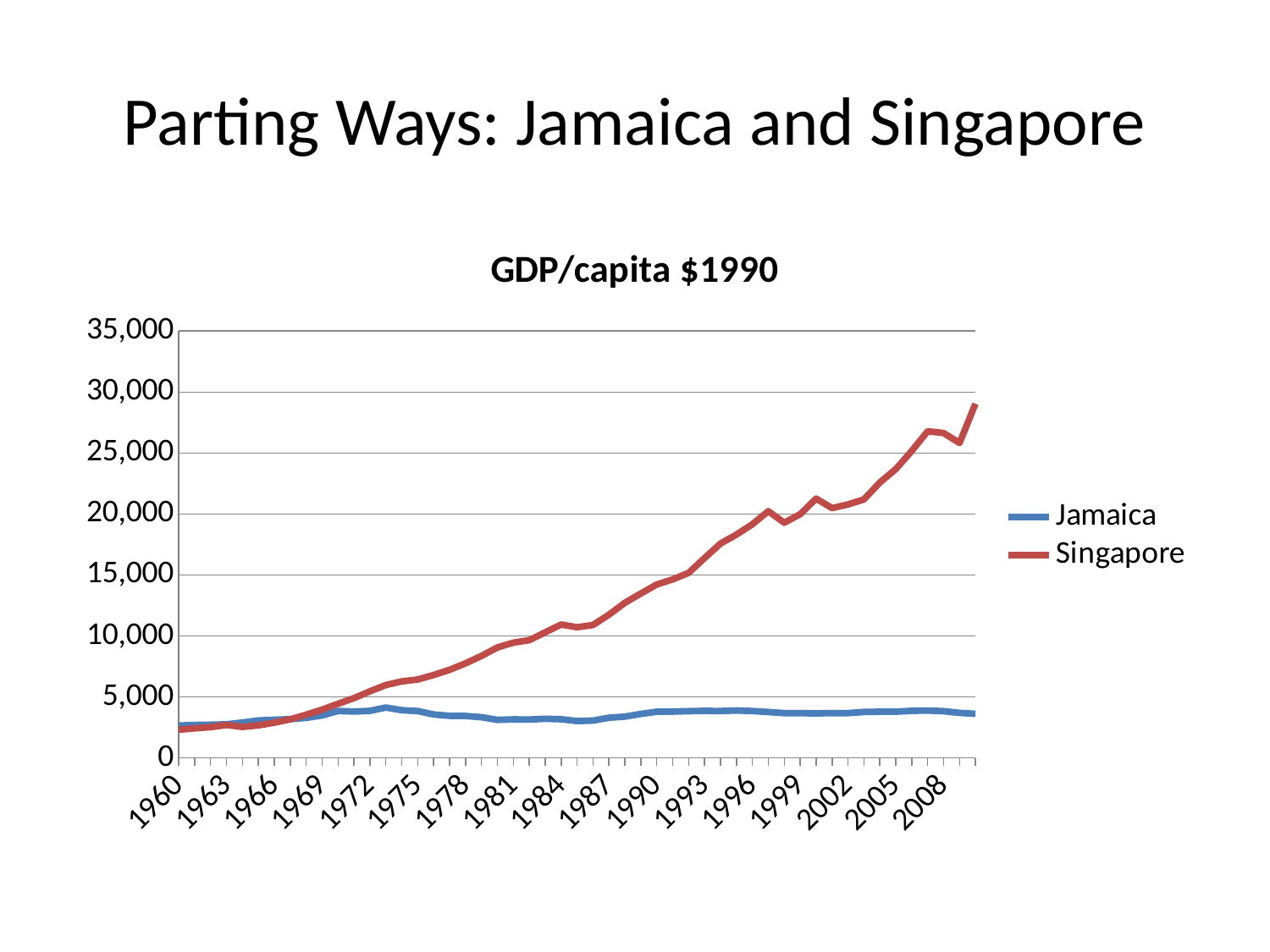
Is the value for Singapore in 1996 greater or less than 15,000? greater Is the value for Singapore in 2008 greater or less than 25,000? greater What is the title of the chart? GDP/capita $1990 Is the value for Singapore in 1960 greater or less than 5,000? less Does the Singapore line generally rise or fall from 1960 to the end of the series? rise Which colour is used for the Singapore line? red How many series does the legend list? 2 Which series has the higher value in 2008, Jamaica or Singapore? Singapore What kind of chart is shown on the slide? line chart Which series reaches the highest value on the chart? Singapore